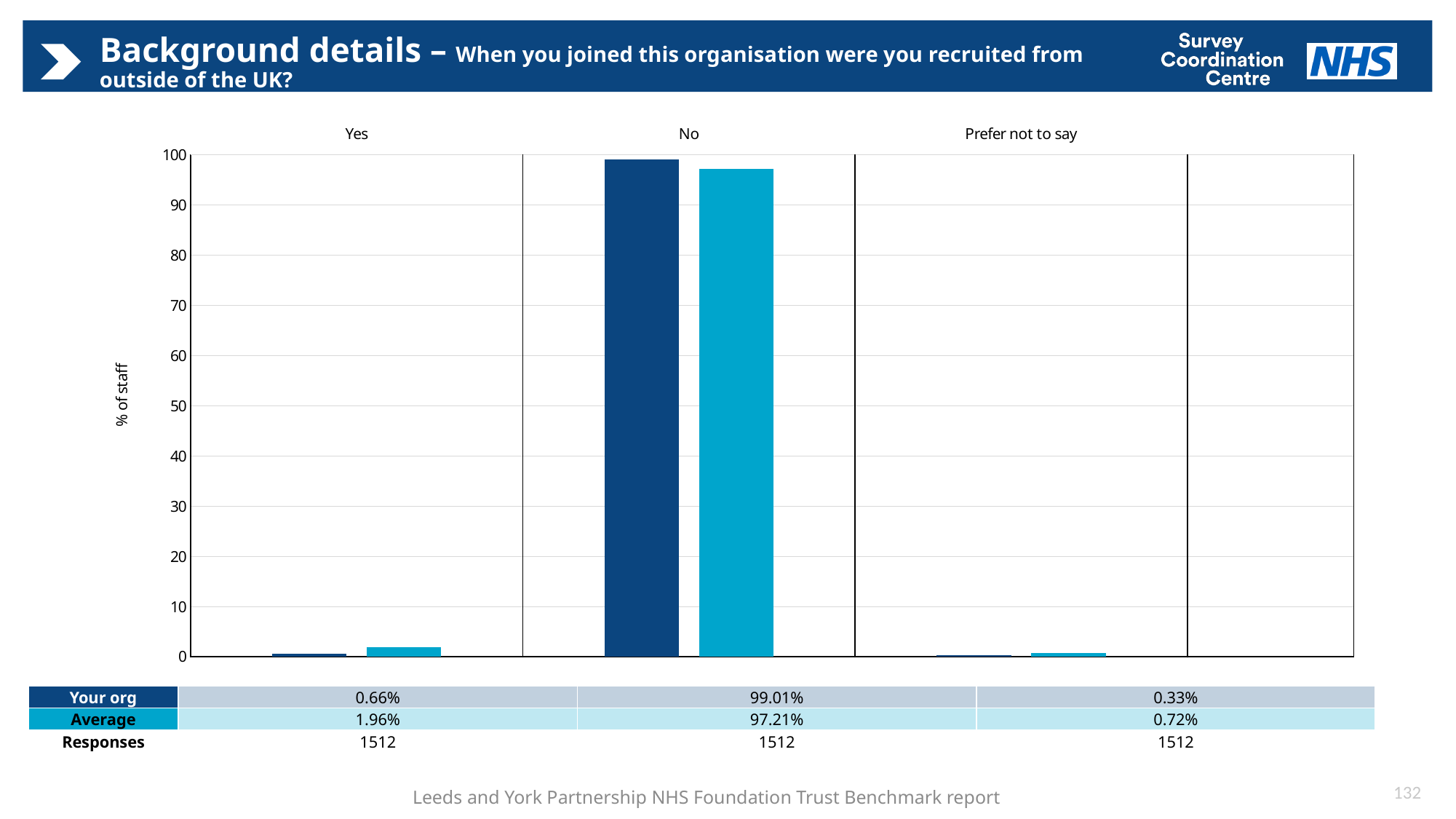
For 'Yes', which is larger: 'Your org' or 'Average'? Average What is the 'Your org' value for 'Prefer not to say'? 0.33% Is the 'Average' value for 'No' greater or less than 90? greater What is the 'Your org' value for 'No'? 99.01% How many series does the chart show? 2 What is the 'Average' value for 'Prefer not to say'? 0.72% What is the 'Average' value for 'Yes'? 1.96% Which category has the lowest 'Your org' value? Prefer not to say What is the difference between the 'Your org' and 'Average' values for 'No'? 1.80% What type of chart is shown on the slide? Bar chart How many response categories are shown on the chart? 3 Which category has the highest 'Your org' value? No